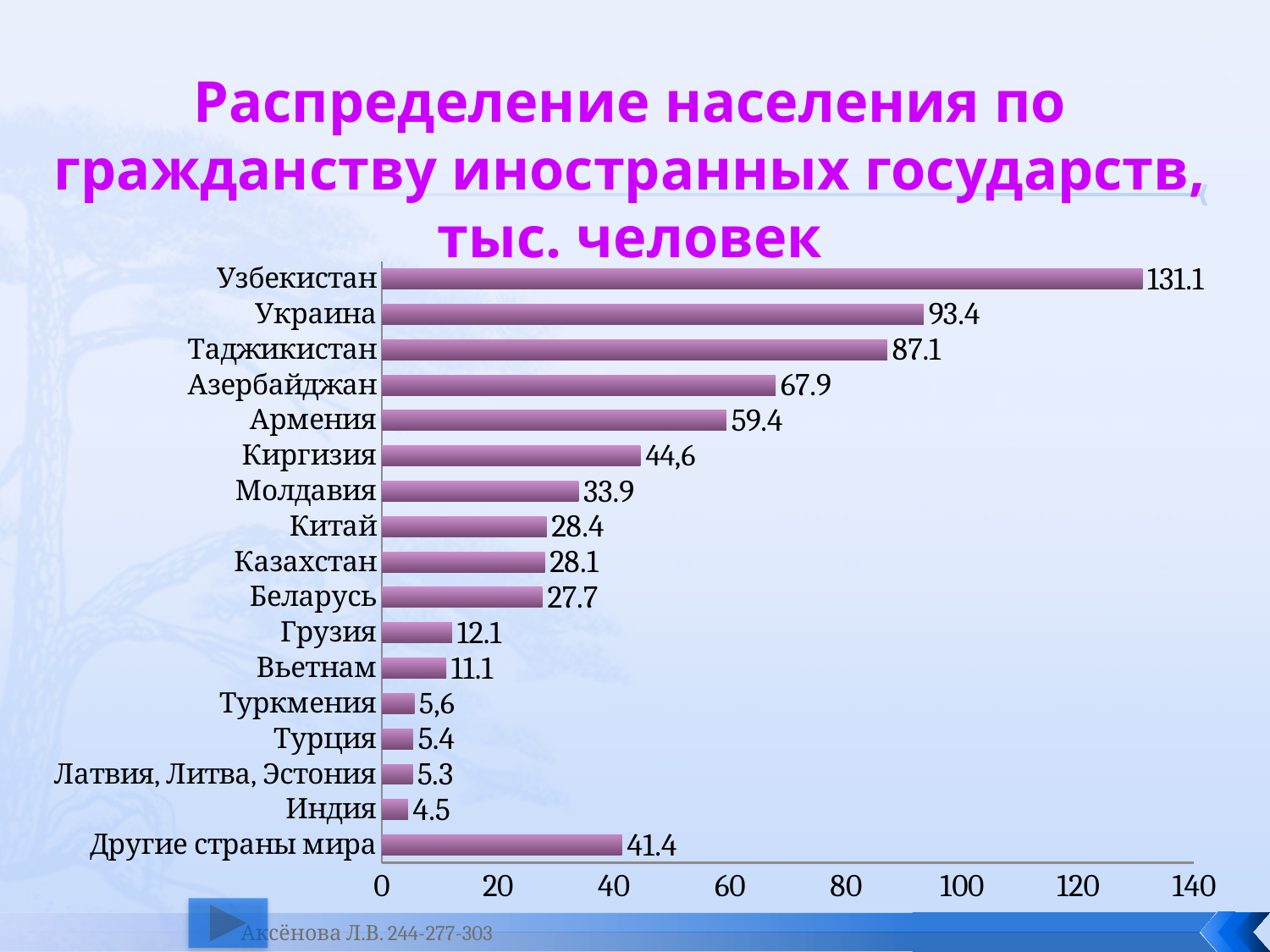
What is the value for Киргизия? 44,6 What is the value for Другие страны мира? 41.4 How many categories are shown in the chart? 17 Which is larger, the value for Армения or the value for Молдавия? Армения What kind of chart is shown on the slide? bar chart Is the value for Азербайджан greater or less than 60? greater What is the difference between the values for Узбекистан and Украина? 37.7 What unit of measurement is stated in the chart title? тыс. человек What is the value for Узбекистан? 131.1 What is the value for Латвия, Литва, Эстония? 5.3 Which category has the highest value? Узбекистан Which category has the lowest value? Индия